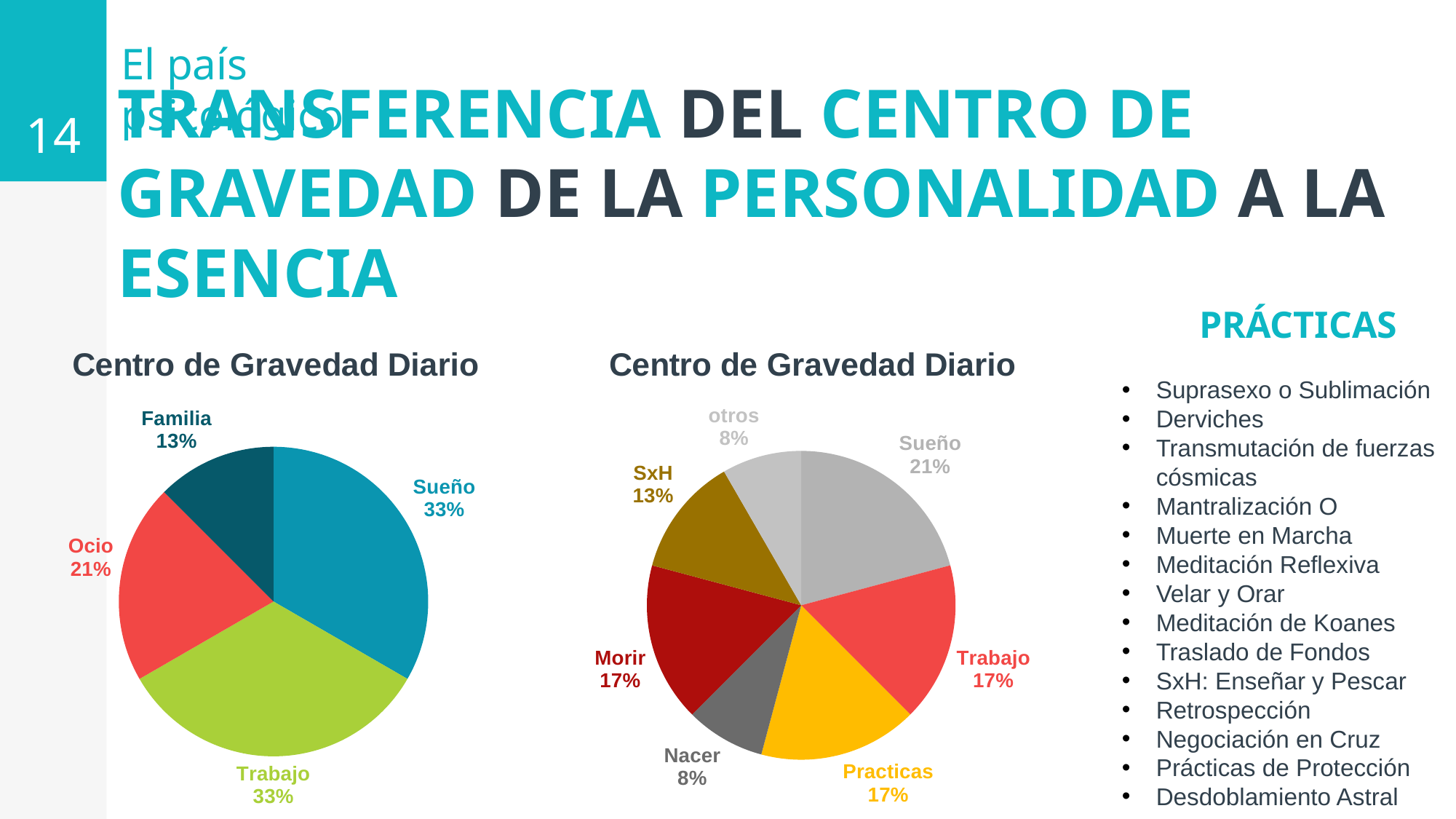
In the left pie chart, which category has the smallest share? Familia In the right pie chart, which category has the largest share? Sueño In the left pie chart, what is the share for Familia? 13% What type of chart is the left chart? Pie chart In the left pie chart, what is the share for Ocio? 21% In the left pie chart, how many slices are there? 4 In the right pie chart, which is larger, Morir or Nacer? Morir In the right pie chart, what is the share for SxH? 13% In the right pie chart, how many slices are there? 7 In the right pie chart, what is the difference between the shares of Sueño and otros? 13% In the right pie chart, what is the share for Sueño? 21% In the left pie chart, what is the difference between the shares of Sueño and Ocio? 12%